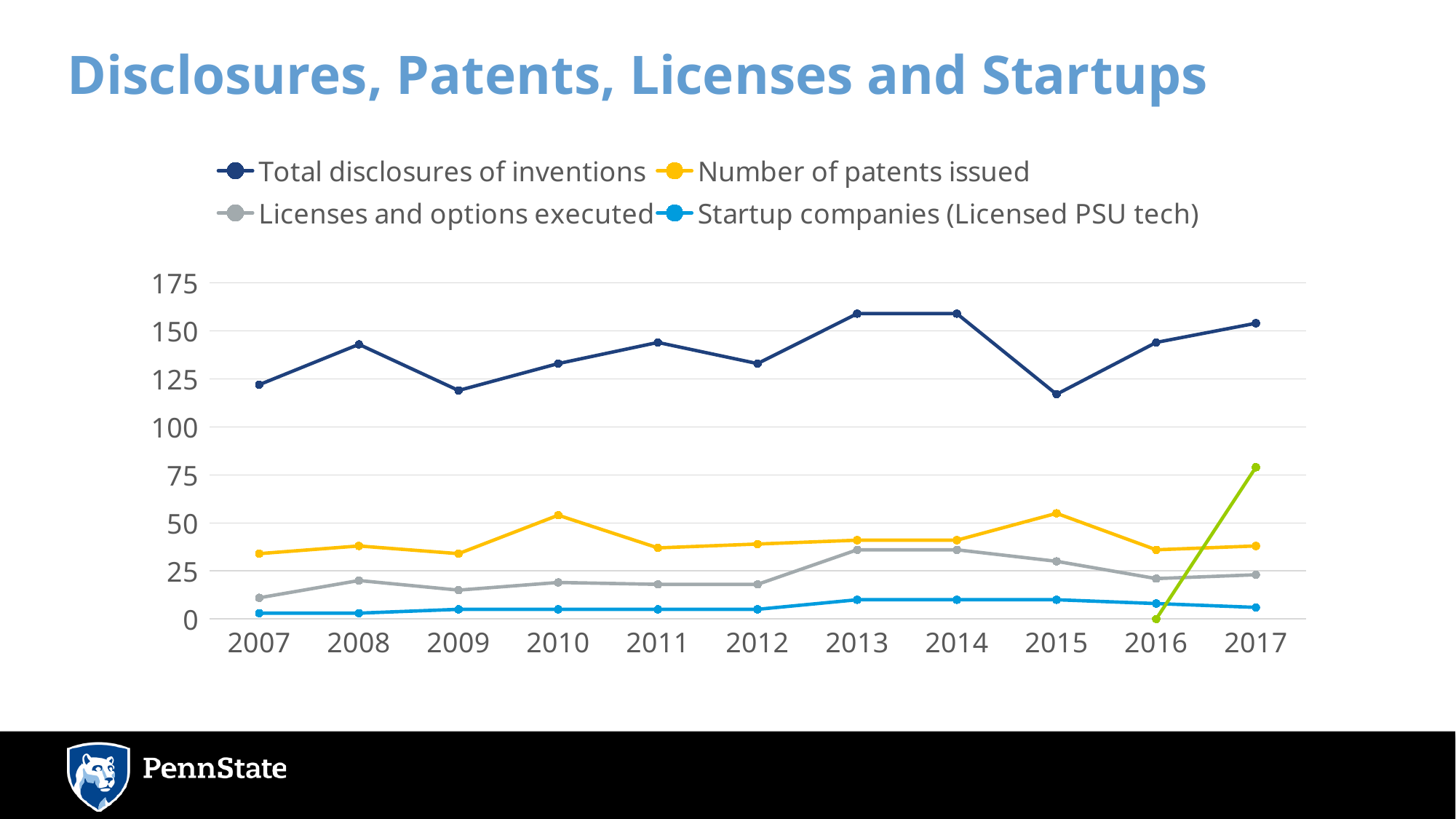
Is the value for Total disclosures of inventions in 2015 greater or less than 125? less Is the value for Total disclosures of inventions in 2013 greater or less than 150? greater Does Total disclosures of inventions rise or fall from 2015 to 2017? rise In which year is Licenses and options executed lowest? 2007 What is the title of the chart? Disclosures, Patents, Licenses and Startups How many series does the legend list? 4 What kind of chart is shown on the slide? line chart Which is larger for Total disclosures of inventions, 2008 or 2009? 2008 How many years are shown on the x axis? 11 Is the value for Licenses and options executed in 2013 greater or less than 25? greater